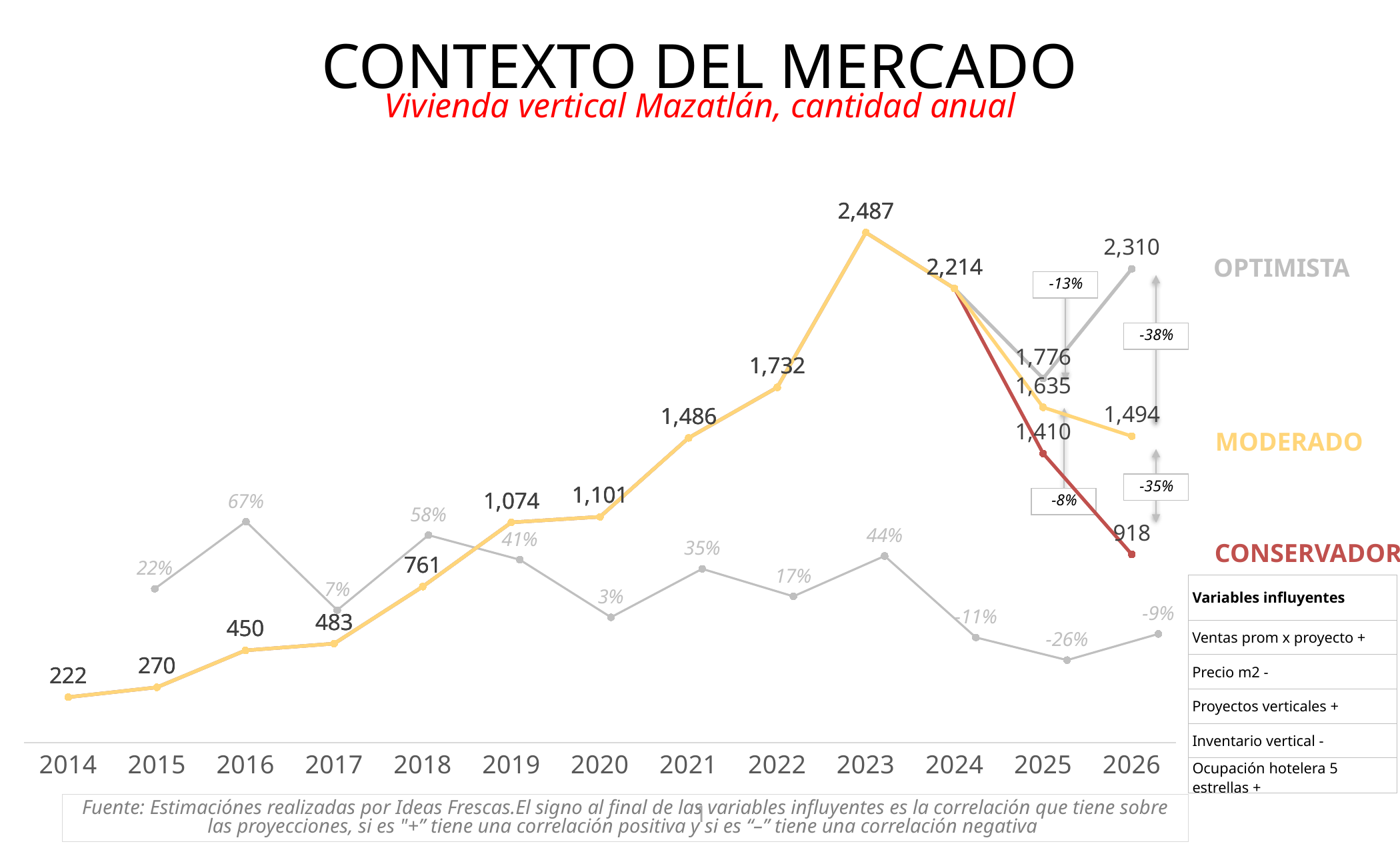
How many years are shown on the x axis? 13 What is the value for 2026 in the OPTIMISTA scenario? 2,310 What is the value for 2023? 2,487 Which year has the highest value on the main line? 2023 What is the value for 2014? 222 Which year has the lowest value on the main line? 2014 What percentage growth is shown for 2016 on the grey line? 67% Which is larger, the value for 2021 or the value for 2022? 2022 What is the difference between the 2023 value and the 2024 value? 273 What is the value for 2025 in the MODERADO scenario? 1,635 What kind of chart is shown on the slide? line chart What is the value for 2026 in the CONSERVADOR scenario? 918